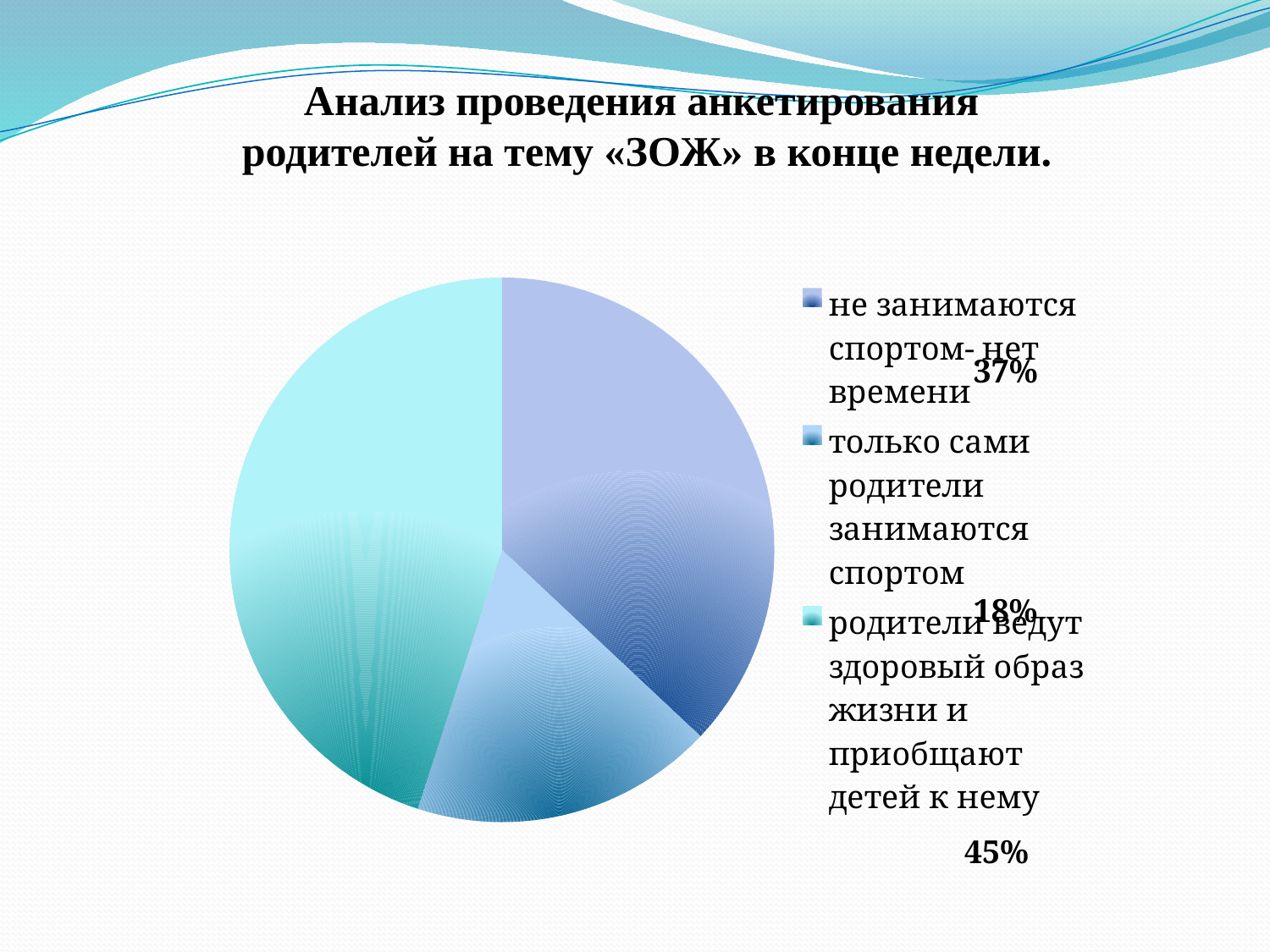
What kind of chart is shown on the slide? pie chart How many slices does the pie chart have? 3 Which legend entry is listed first in the pie chart's legend? не занимаются спортом- нет времени What is the difference in percentage points between "родители ведут здоровый образ жизни и приобщают детей к нему" and "не занимаются спортом- нет времени"? 8 What percentage is shown for "родители ведут здоровый образ жизни и приобщают детей к нему"? 45% How many entries does the legend of the pie chart list? 3 What percentage is shown for "не занимаются спортом- нет времени"? 37% Which category has the smallest share of the pie? только сами родители занимаются спортом What percentage is shown for "только сами родители занимаются спортом"? 18% What is the title of the slide containing the pie chart? Анализ проведения анкетирования родителей на тему «ЗОЖ» в конце недели. Which category has the largest share of the pie? родители ведут здоровый образ жизни и приобщают детей к нему Which is larger: the share for "не занимаются спортом- нет времени" or the share for "только сами родители занимаются спортом"? не занимаются спортом- нет времени